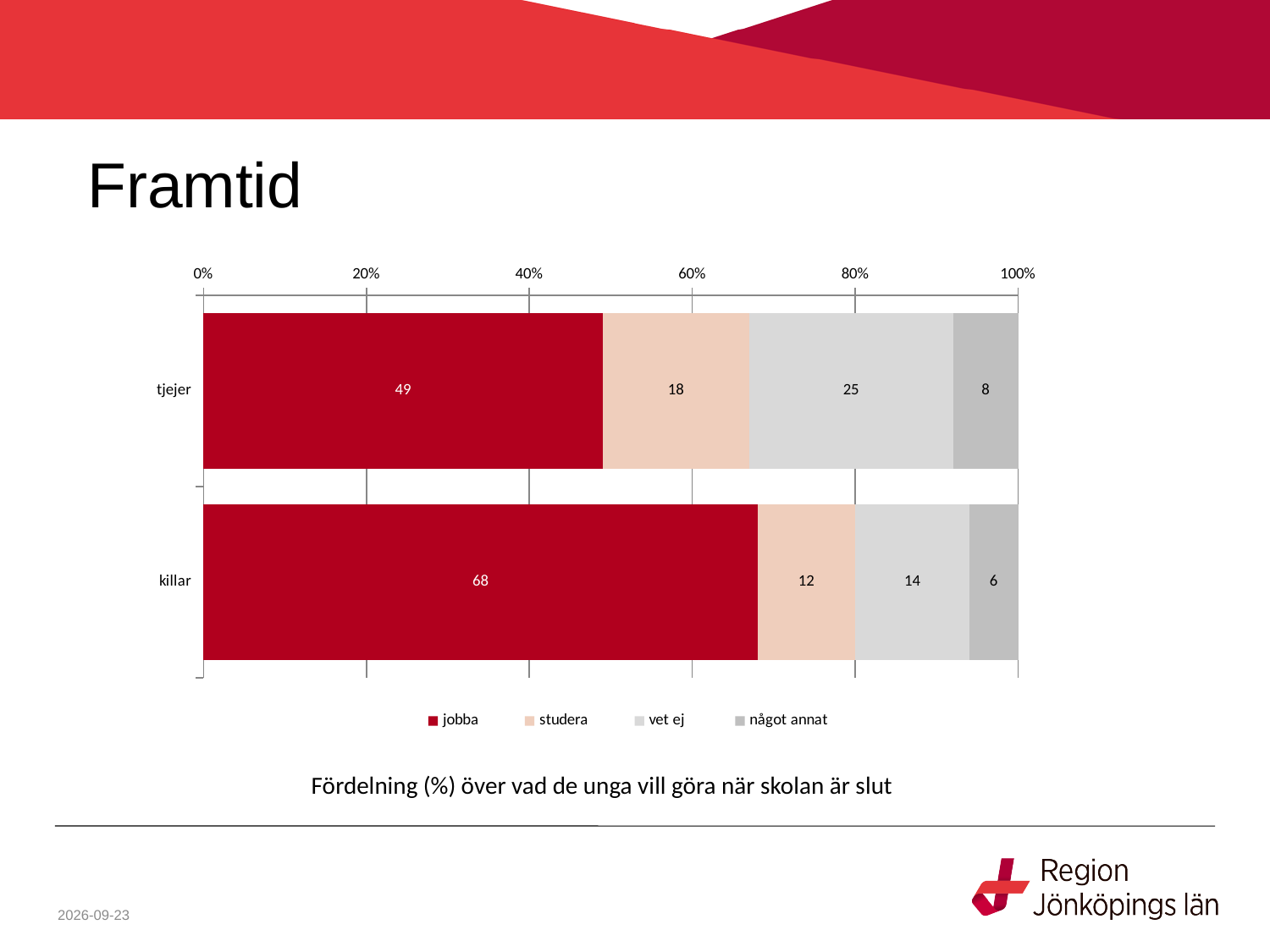
What is the total of the stacked bar for tjejer? 100 What is the value for 'studera' for killar? 12 What is the difference between the 'jobba' values for killar and tjejer? 19 How many series does the legend list? 4 What is the value for 'något annat' for killar? 6 What is the value for 'vet ej' for tjejer? 25 What is the difference between the 'vet ej' values for tjejer and killar? 11 Which series is shown in dark red in the legend? jobba What is the value for 'jobba' for tjejer? 49 How many categories are shown on the chart? 2 Which category has the higher value for 'jobba', tjejer or killar? killar What kind of chart is shown on the slide? Stacked bar chart